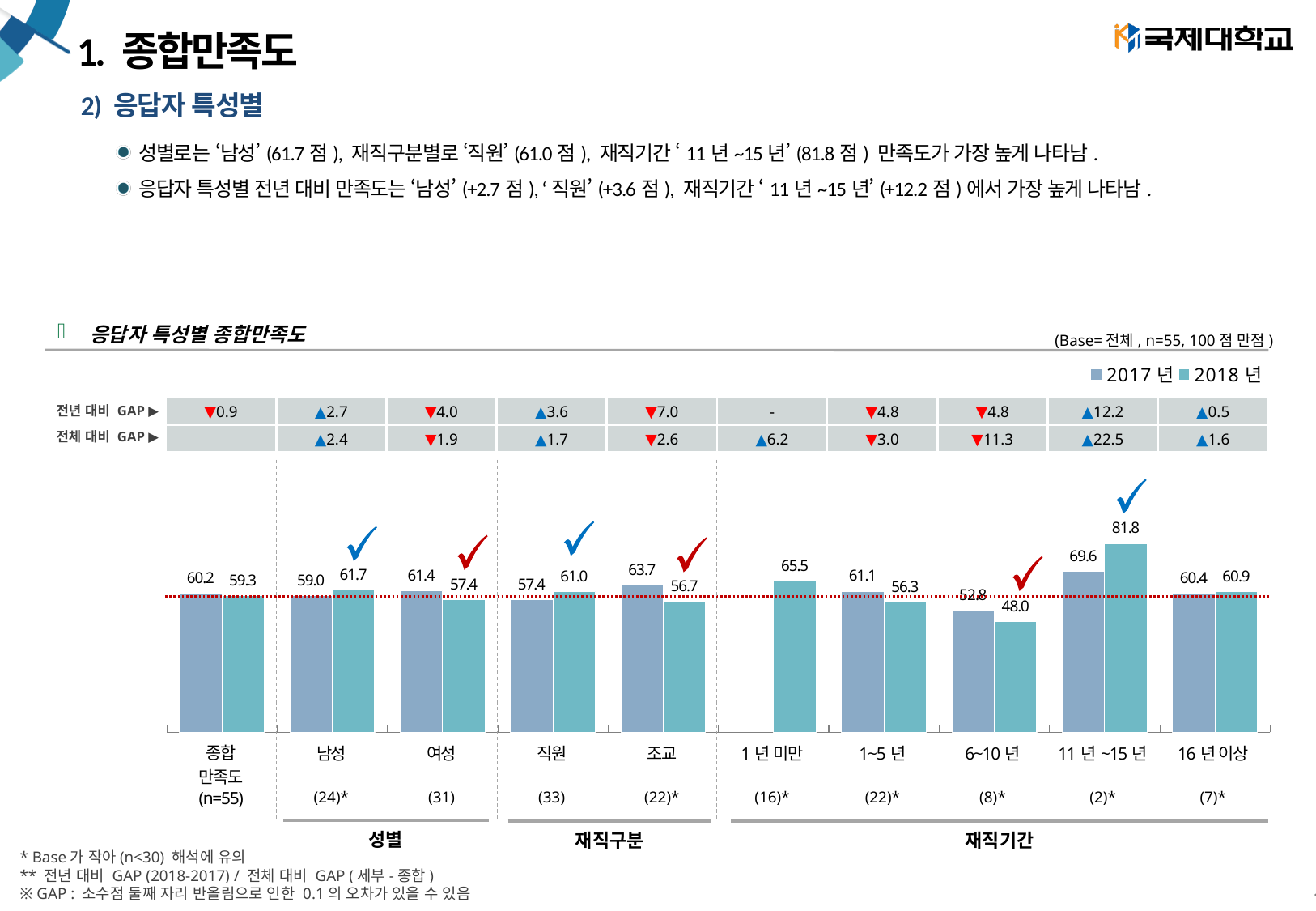
What is the 2018년 value for 1년 미만? 65.5 Which category has the lowest 2018년 value? 6~10년 What is the 2017년 value for 조교? 63.7 What is the 2018년 value for 11년~15년? 81.8 How many series does the legend list? 2 What is the difference between the 2018년 and 2017년 values for 직원? 3.6 What is the 전년 대비 GAP shown for 11년~15년? ▲12.2 What is the 2018년 value for 남성? 61.7 What kind of chart is shown on the slide? Bar chart What is the 2017년 value for 종합만족도 (n=55)? 60.2 Which is larger for 여성: the 2017년 value or the 2018년 value? 2017년 Which category has the highest 2018년 value? 11년~15년